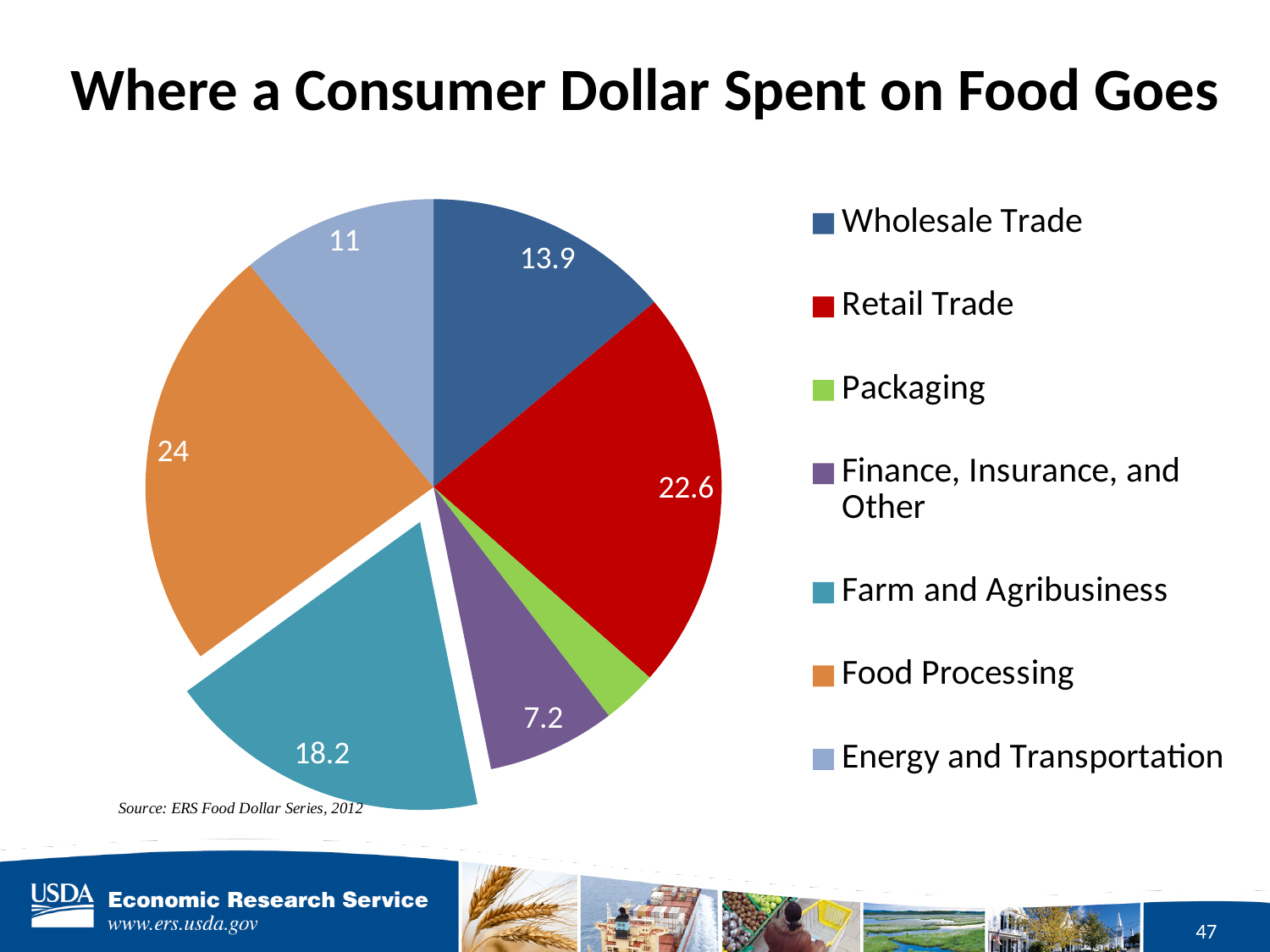
How many entries does the legend list? 7 Which is larger, the value for Farm and Agribusiness or the value for Finance, Insurance, and Other? Farm and Agribusiness Which category has the largest slice of the pie? Food Processing What kind of chart is shown on the slide? pie chart What value is shown for Farm and Agribusiness? 18.2 Which category has the smallest slice of the pie? Packaging What value is shown for Energy and Transportation? 11 What is the difference between the values for Retail Trade and Wholesale Trade? 8.7 What value is shown for Food Processing? 24 How many slices does the pie chart have? 7 What value is shown for Retail Trade? 22.6 Which slice is pulled out from the rest of the pie? Farm and Agribusiness